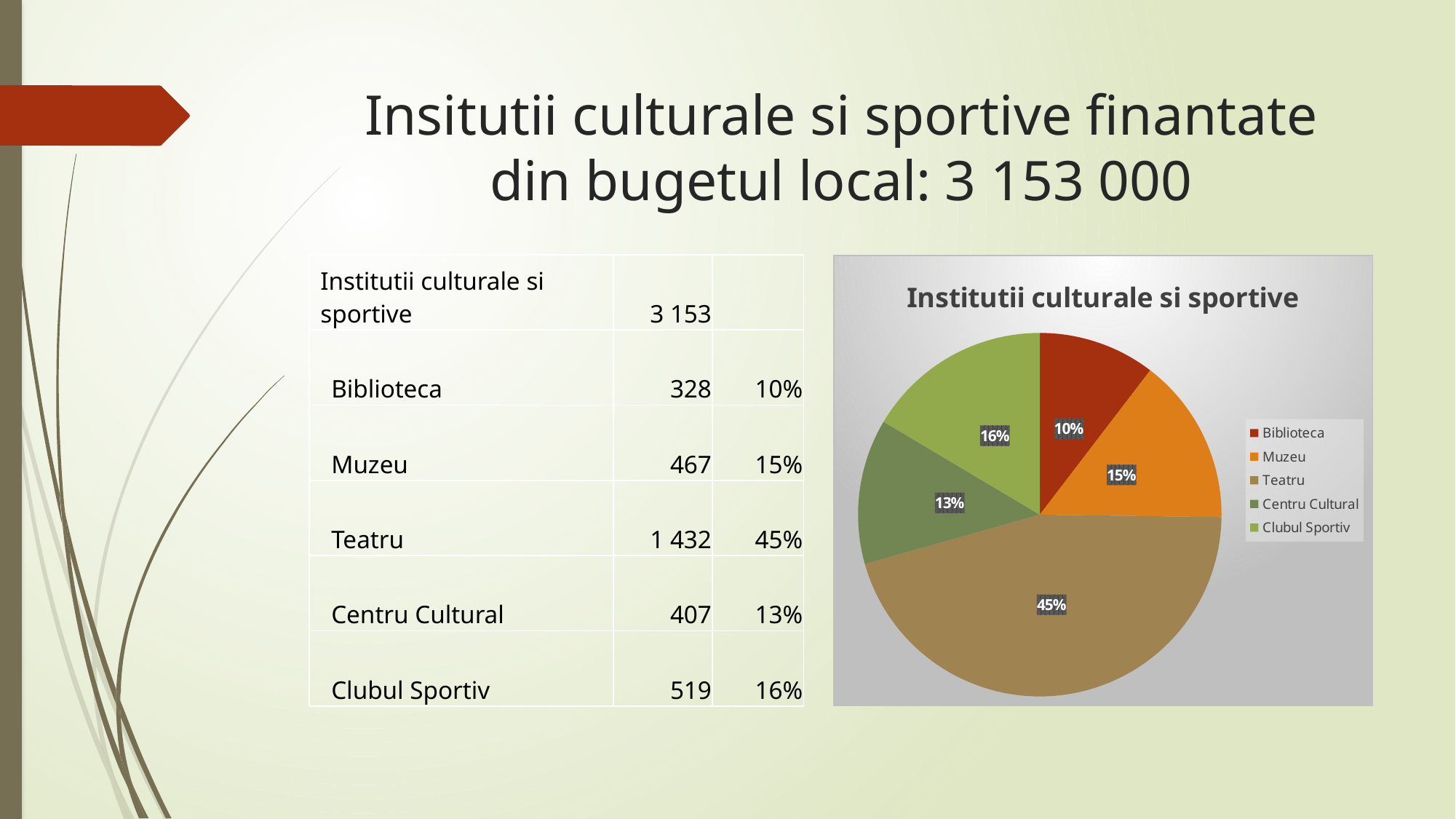
Which category has the largest slice of the pie? Teatru What share of the pie does Teatru represent? 45% What share of the pie does Centru Cultural represent? 13% Which category has the smallest slice of the pie? Biblioteca What type of chart is shown on the slide? pie chart What is the difference in percentage points between the Teatru slice and the Muzeu slice? 30% What share of the pie does Biblioteca represent? 10% Which slice is larger, Muzeu or Clubul Sportiv? Clubul Sportiv How many entries does the chart legend list? 5 What is the title of the chart? Institutii culturale si sportive How many slices does the pie chart have? 5